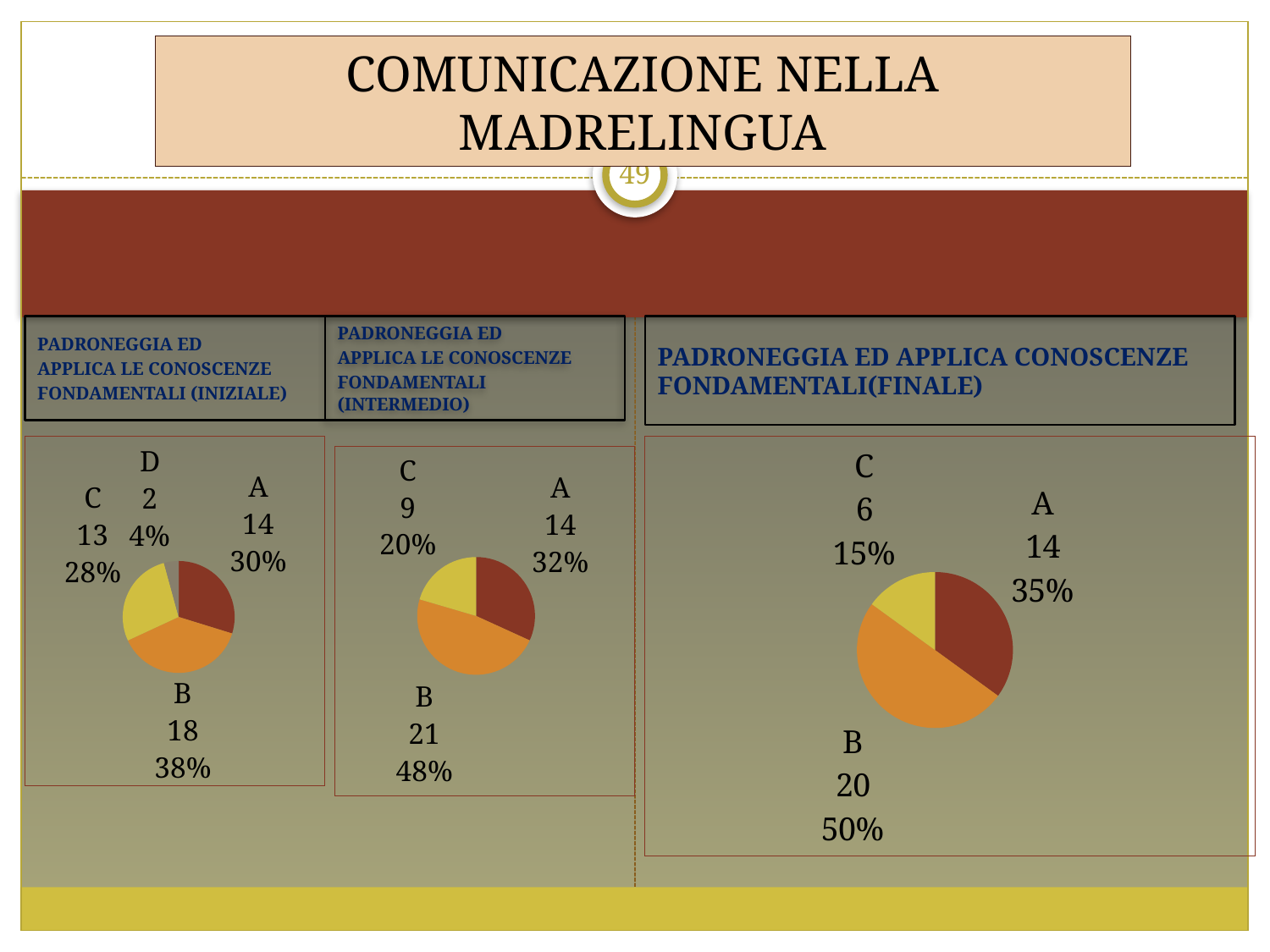
In the right pie chart (FINALE), what is the value for category C? 6 In the right pie chart (FINALE), what percentage share does category B have? 50% In the left pie chart (INIZIALE), what is the value for category B? 18 In the right pie chart (FINALE), which is larger, the value for A or the value for C? A In the middle pie chart (INTERMEDIO), what is the value for category C? 9 In the left pie chart (INIZIALE), what percentage share does category D have? 4% What kind of chart is used on this slide? Pie chart In the middle pie chart (INTERMEDIO), which category has the highest value? B How many categories are shown in the left pie chart (INIZIALE)? 4 In the middle pie chart (INTERMEDIO), what is the difference between the values for B and A? 7 In the left pie chart (INIZIALE), which category has the lowest value? D How many categories are shown in the right pie chart (FINALE)? 3